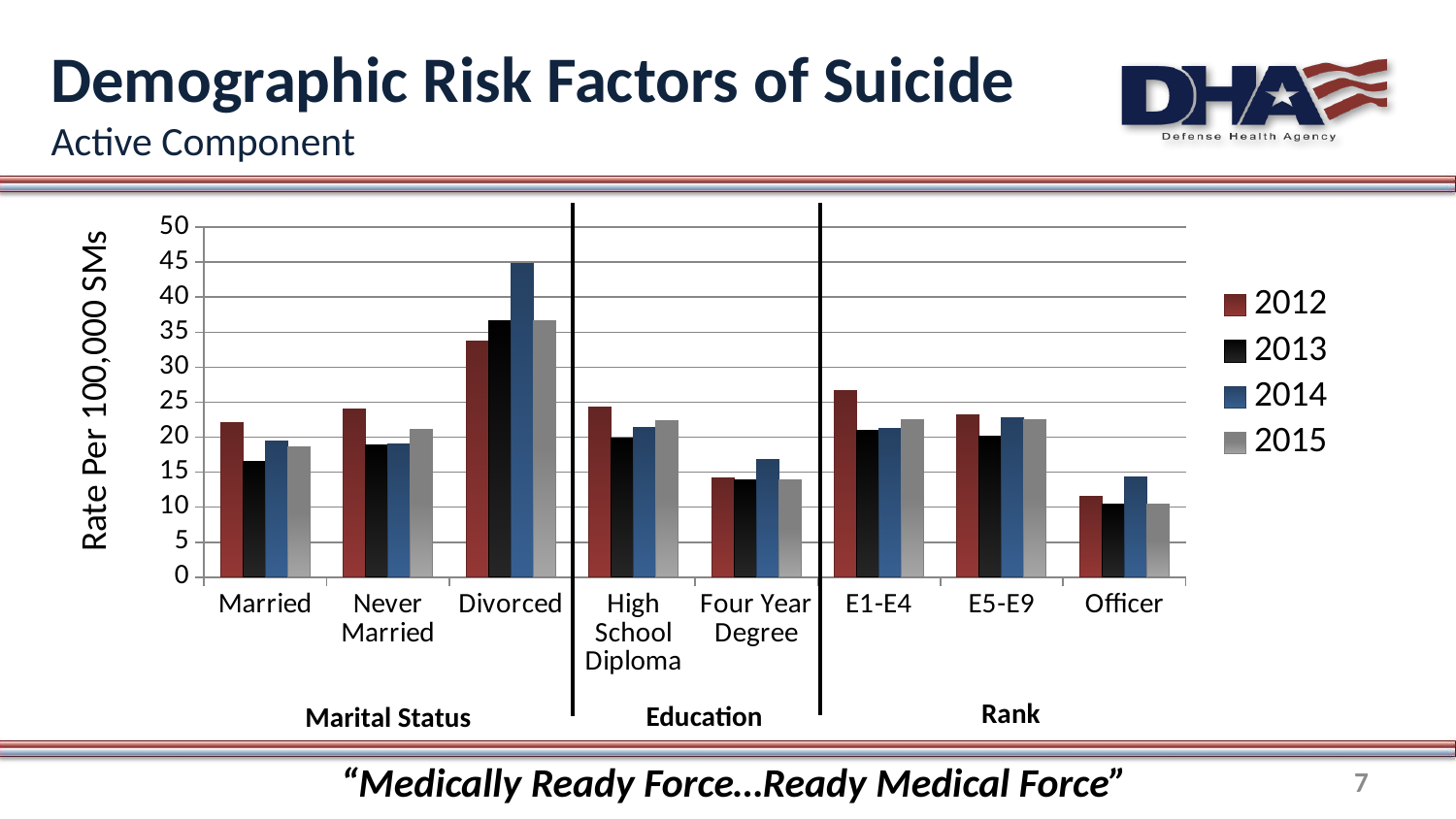
Which category has the highest value for 2014? Divorced How many series does the legend list? 4 Is the 2013 value for Officer greater or less than 15? less Is the 2014 value for Divorced greater or less than 40? greater Is the 2014 value for Four Year Degree greater or less than 20? less How many categories are shown along the x axis? 8 For E1-E4, which year has the larger value, 2012 or 2013? 2012 What kind of chart is shown on the slide? bar chart Which category has the lowest value for 2012? Officer What is the label on the y axis? Rate Per 100,000 SMs For Divorced, which year has the larger value, 2012 or 2014? 2014